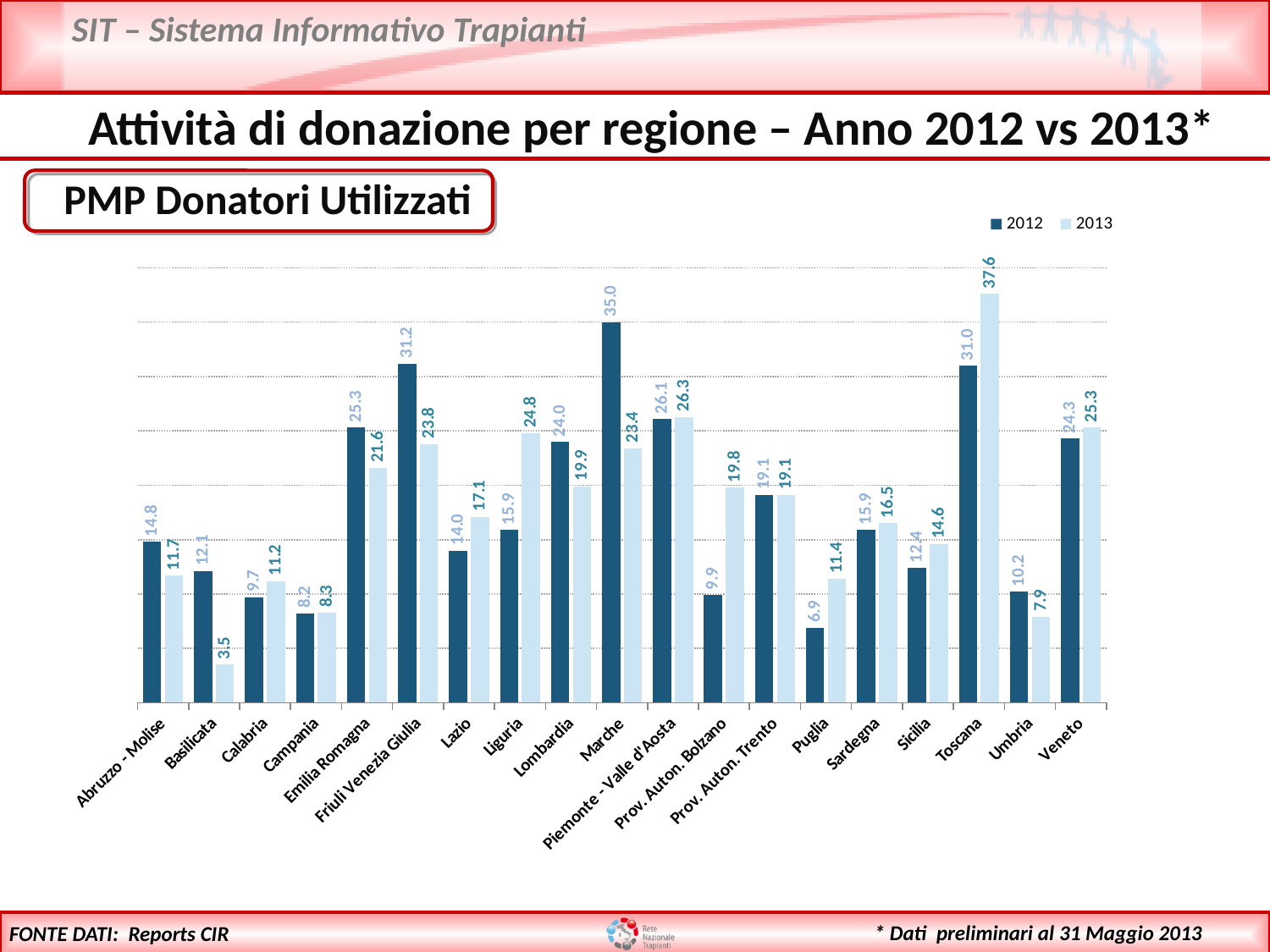
Which region has the highest 2012 value? Marche What is the difference between the 2012 and 2013 values for Marche? 11.6 What is the 2012 value for Prov. Auton. Bolzano? 9.9 What is the 2013 value for Basilicata? 3.5 What is the 2013 value for Toscana? 37.6 How many regions are shown on the x axis? 19 What is the 2012 value for Marche? 35.0 How many series does the legend list? 2 Which region has the lowest 2013 value? Basilicata Which region has the highest 2013 value? Toscana Which is larger for Liguria, the 2012 value or the 2013 value? 2013 Which region has the lowest 2012 value? Puglia